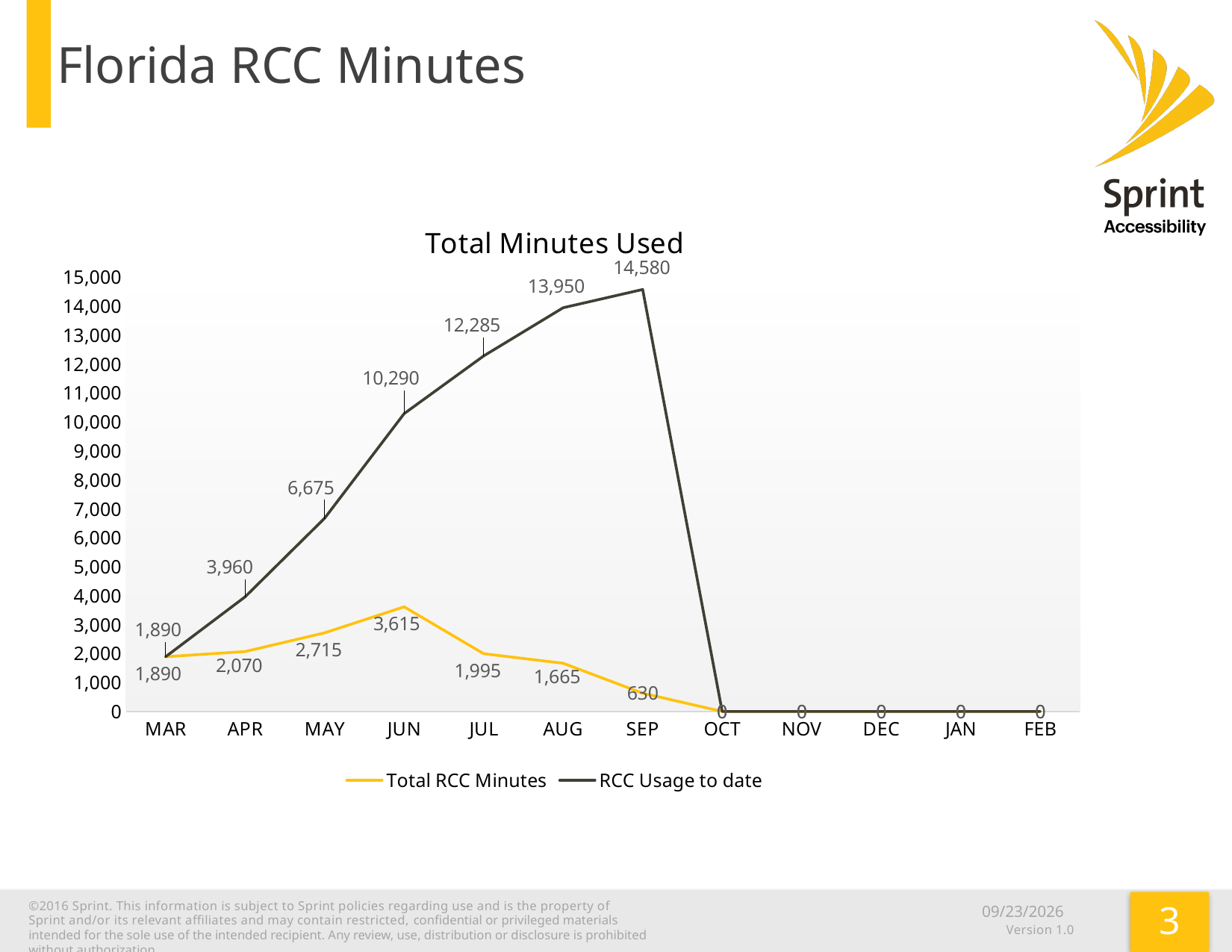
What is the title of the chart? Total Minutes Used What is the value of RCC Usage to date for SEP? 14,580 What is the value of Total RCC Minutes for JUN? 3,615 In which month does RCC Usage to date reach its highest value? SEP Does RCC Usage to date rise or fall from MAR to SEP? Rise How many months are shown on the x axis? 12 Which is larger: Total RCC Minutes in MAY or in JUL? MAY In which month does Total RCC Minutes reach its highest value? JUN What type of chart is shown on the slide? Line chart How many series does the legend list? 2 What is the difference between RCC Usage to date in AUG and in JUL? 1,665 What is the value of Total RCC Minutes for SEP? 630